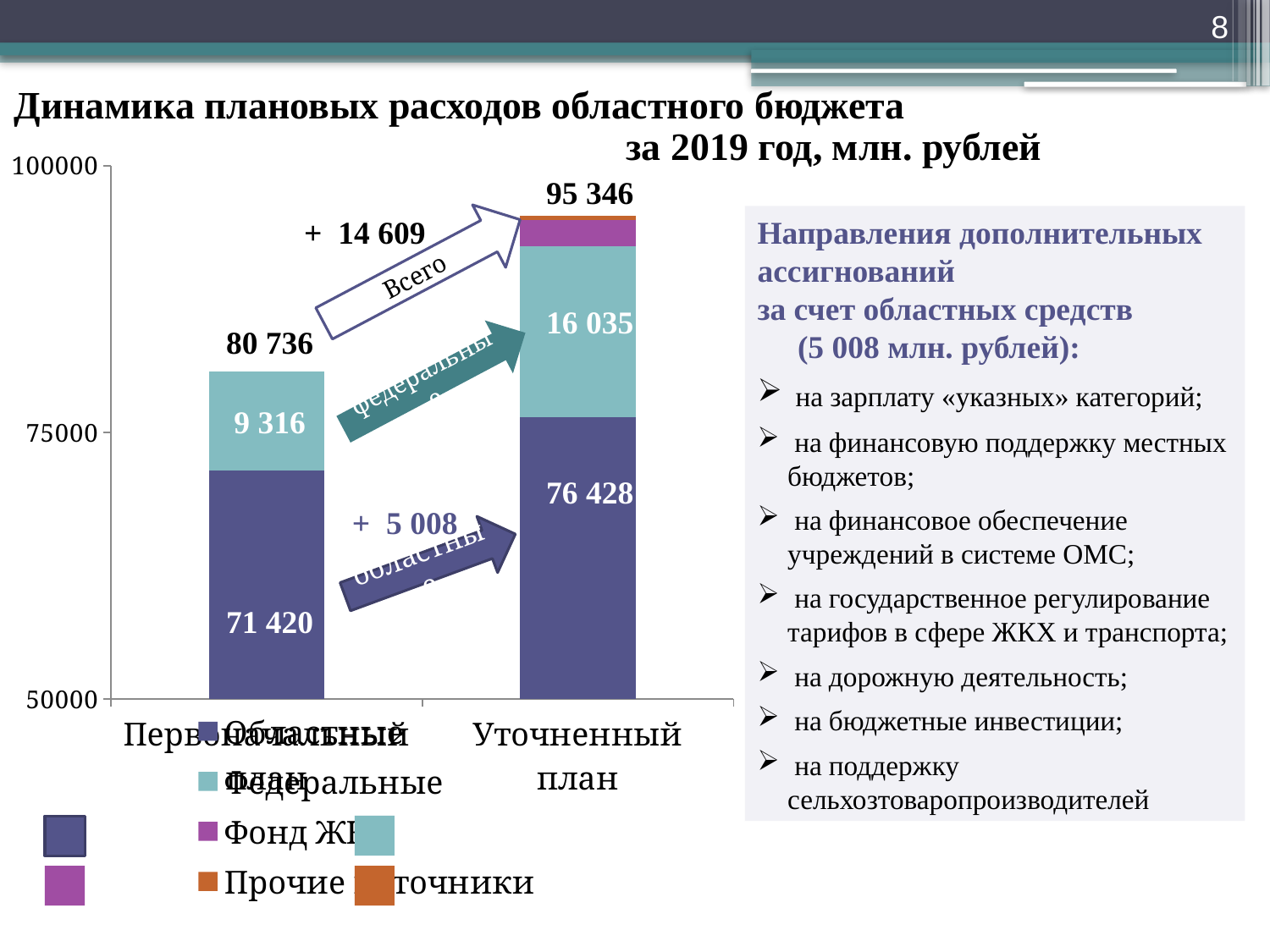
What is the total of the Первоначальный план bar? 80 736 By how much does the total of Уточненный план exceed the total of Первоначальный план? 14 609 Which plan has the larger Федеральные segment, Первоначальный план or Уточненный план? Уточненный план What kind of chart is shown on the slide? stacked bar chart How many series does the legend list? 4 What is the total of the Уточненный план bar? 95 346 By how much does the Областные segment increase from Первоначальный план to Уточненный план? 5 008 By how much does the Федеральные segment increase from Первоначальный план to Уточненный план? 6 719 What is the value of the Областные segment for Уточненный план? 76 428 What is the value of the Областные segment for Первоначальный план? 71 420 Do the bar totals rise or fall from Первоначальный план to Уточненный план? rise What is the value of the Федеральные segment for Уточненный план? 16 035